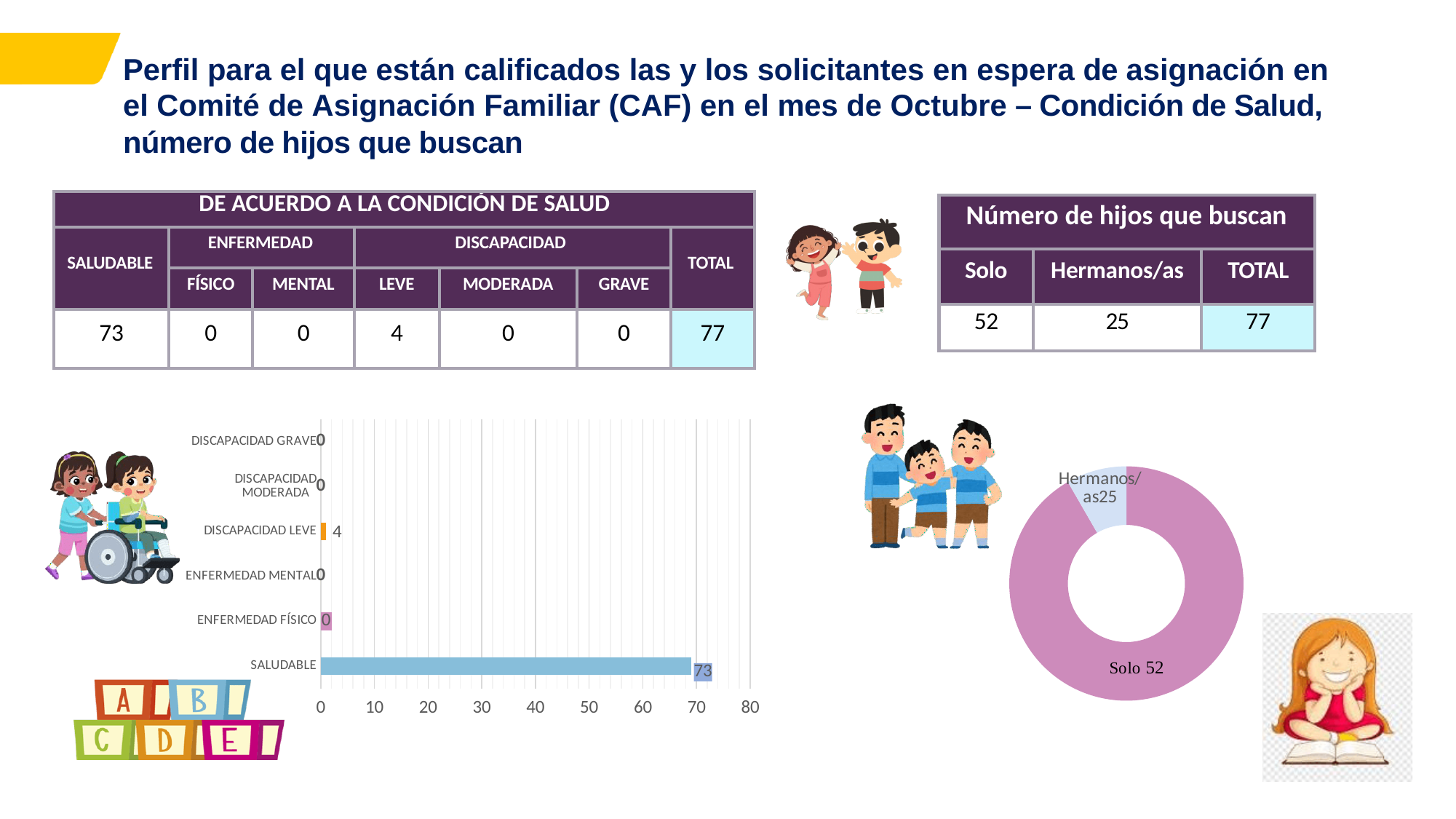
In the bar chart on the left, what is the value for SALUDABLE? 73 In the donut chart on the right, what is the value for Solo? 52 In the bar chart on the left, which is larger, the value for SALUDABLE or the value for DISCAPACIDAD LEVE? SALUDABLE In the donut chart on the right, what is the value for Hermanos/as? 25 In the bar chart on the left, what is the value for ENFERMEDAD MENTAL? 0 In the bar chart on the left, what is the difference between the values for SALUDABLE and DISCAPACIDAD LEVE? 69 In the bar chart on the left, which category has the highest value? SALUDABLE What kind of chart is the chart on the left of the slide? bar chart In the donut chart on the right, which is larger, Solo or Hermanos/as? Solo How many categories are shown in the bar chart on the left? 6 In the bar chart on the left, what is the value for DISCAPACIDAD LEVE? 4